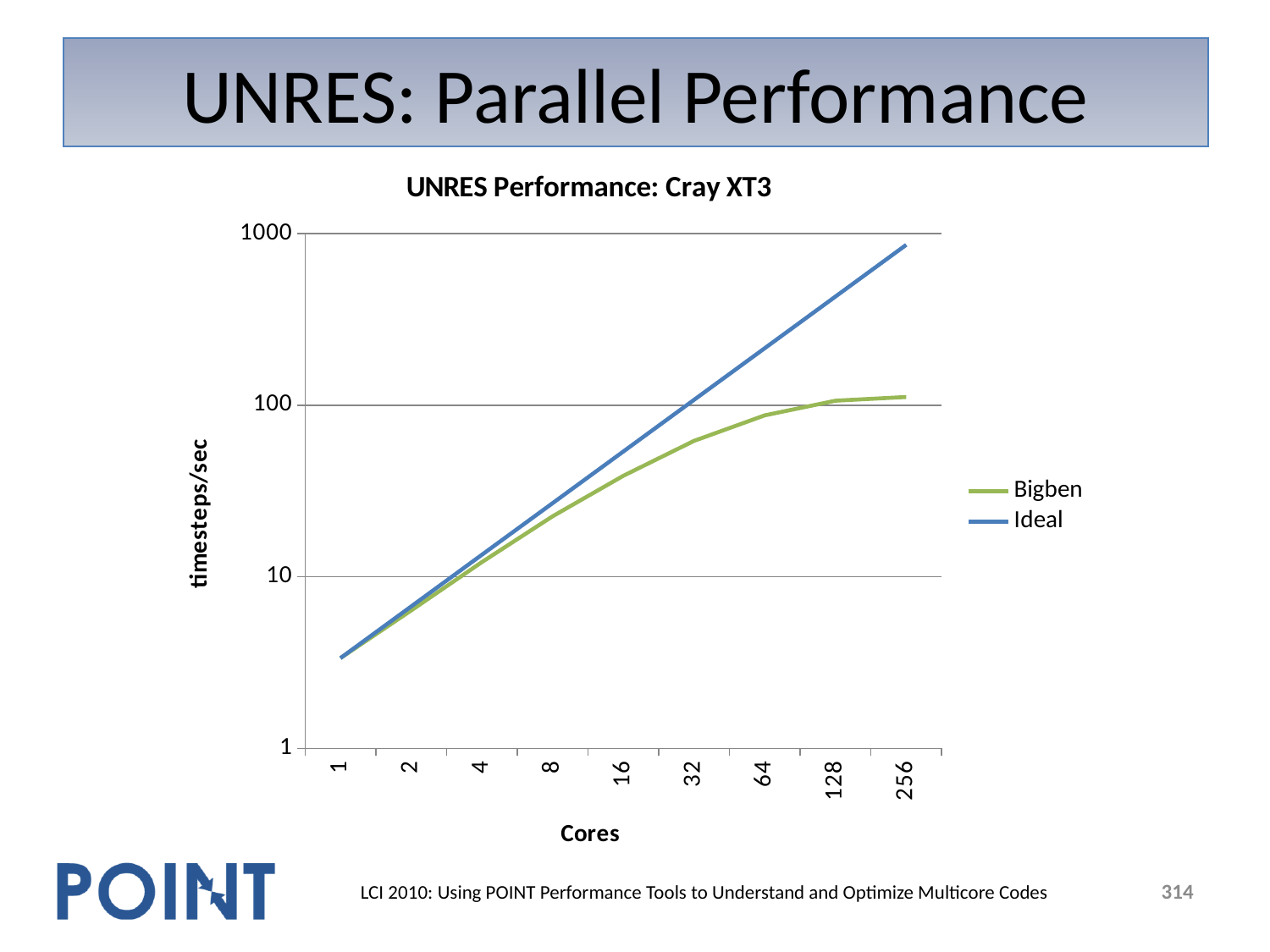
How many series does the legend list? 2 Is the value for Ideal at 1 core greater or less than 10? less At 256 cores, which series has the higher value, Bigben or Ideal? Ideal Is the value for Bigben at 64 cores greater or less than 100? less Is the value for Ideal at 256 cores greater or less than 100? greater What is the label of the y axis? timesteps/sec What kind of chart is shown on the slide? line chart Does the Bigben series rise or fall as the number of cores increases? rise What is the title of the chart? UNRES Performance: Cray XT3 How many core counts are marked along the x axis? 9 At 128 cores, which series has the higher value, Bigben or Ideal? Ideal